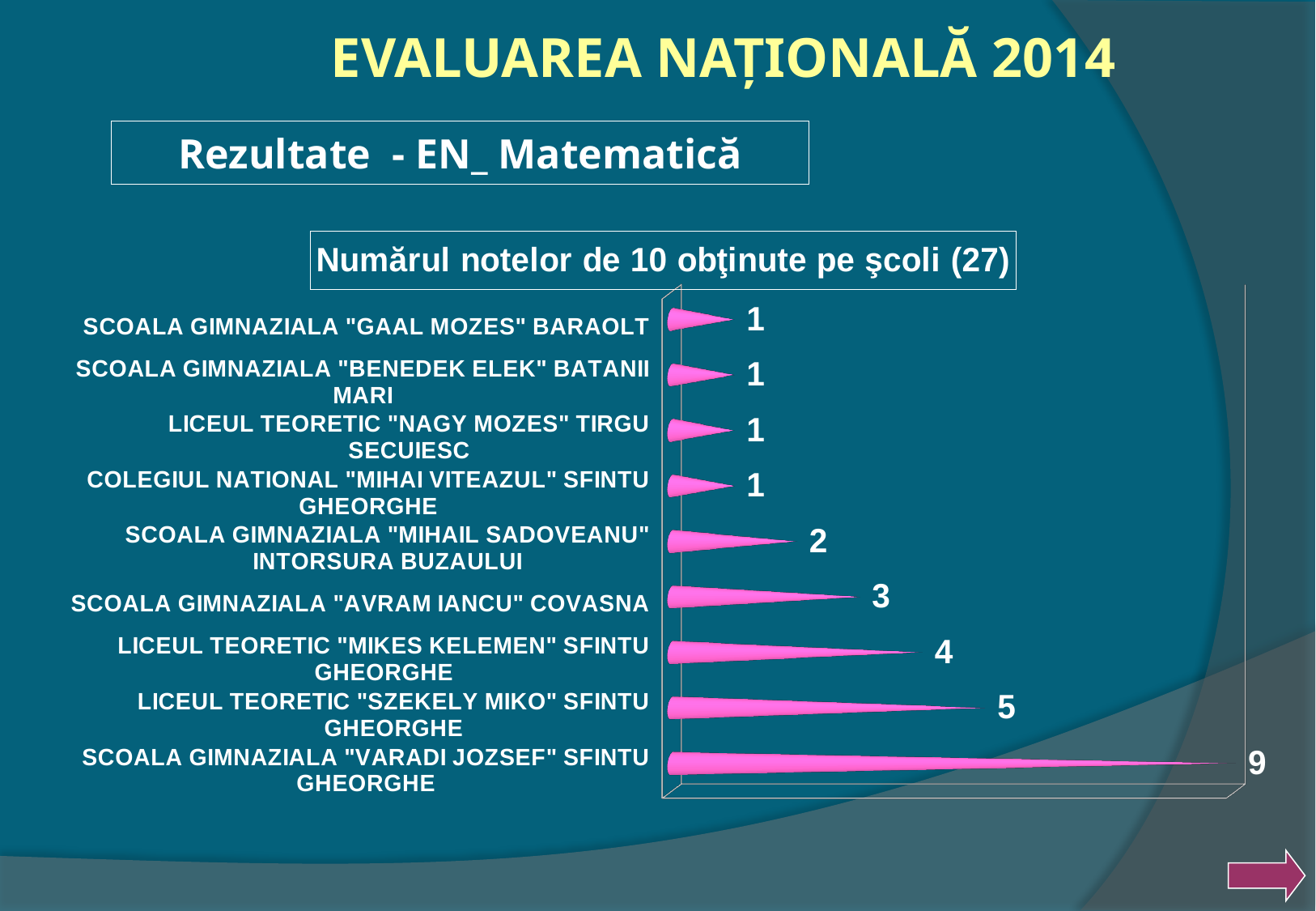
What kind of chart is shown on the slide? Bar chart What is the value shown for SCOALA GIMNAZIALA "AVRAM IANCU" COVASNA? 3 What is the value shown for LICEUL TEORETIC "SZEKELY MIKO" SFINTU GHEORGHE? 5 What is the difference between the values for SCOALA GIMNAZIALA "VARADI JOZSEF" SFINTU GHEORGHE and LICEUL TEORETIC "SZEKELY MIKO" SFINTU GHEORGHE? 4 What is the value shown for SCOALA GIMNAZIALA "MIHAIL SADOVEANU" INTORSURA BUZAULUI? 2 What is the difference between the values for LICEUL TEORETIC "MIKES KELEMEN" SFINTU GHEORGHE and SCOALA GIMNAZIALA "AVRAM IANCU" COVASNA? 1 How many grades of 10 did SCOALA GIMNAZIALA "VARADI JOZSEF" SFINTU GHEORGHE obtain? 9 How many schools have a value of 1? 4 What is the title of the chart? Numărul notelor de 10 obţinute pe şcoli (27) Which school has the highest number of grades of 10? SCOALA GIMNAZIALA "VARADI JOZSEF" SFINTU GHEORGHE Which has a larger value: LICEUL TEORETIC "MIKES KELEMEN" SFINTU GHEORGHE or SCOALA GIMNAZIALA "MIHAIL SADOVEANU" INTORSURA BUZAULUI? LICEUL TEORETIC "MIKES KELEMEN" SFINTU GHEORGHE How many schools are listed in the chart? 9